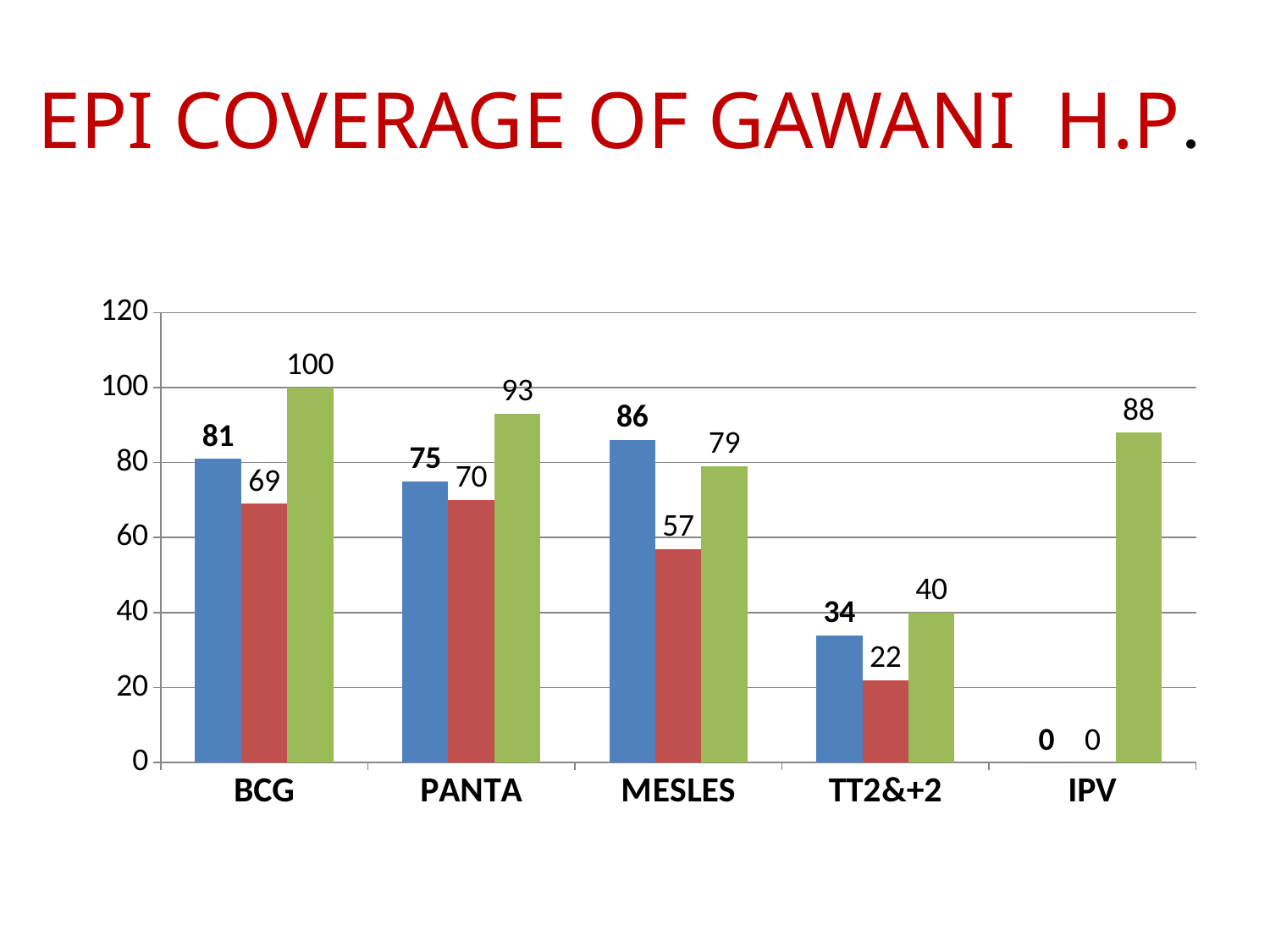
Which is larger for MESLES, the blue bar or the green bar? the blue bar What is the value of the green bar for BCG? 100 What is the value of the green bar for IPV? 88 What is the value of the red bar for TT2&+2? 22 What kind of chart is shown on the slide? bar chart What is the difference between the green bar and the red bar for PANTA? 23 Which category has the highest green bar? BCG What is the value of the blue bar for MESLES? 86 How many categories are shown on the x axis? 5 What is the difference between the blue bar for BCG and the blue bar for TT2&+2? 47 Which category has the lowest blue bar? IPV What is the title of the slide? EPI COVERAGE OF GAWANI H.P.